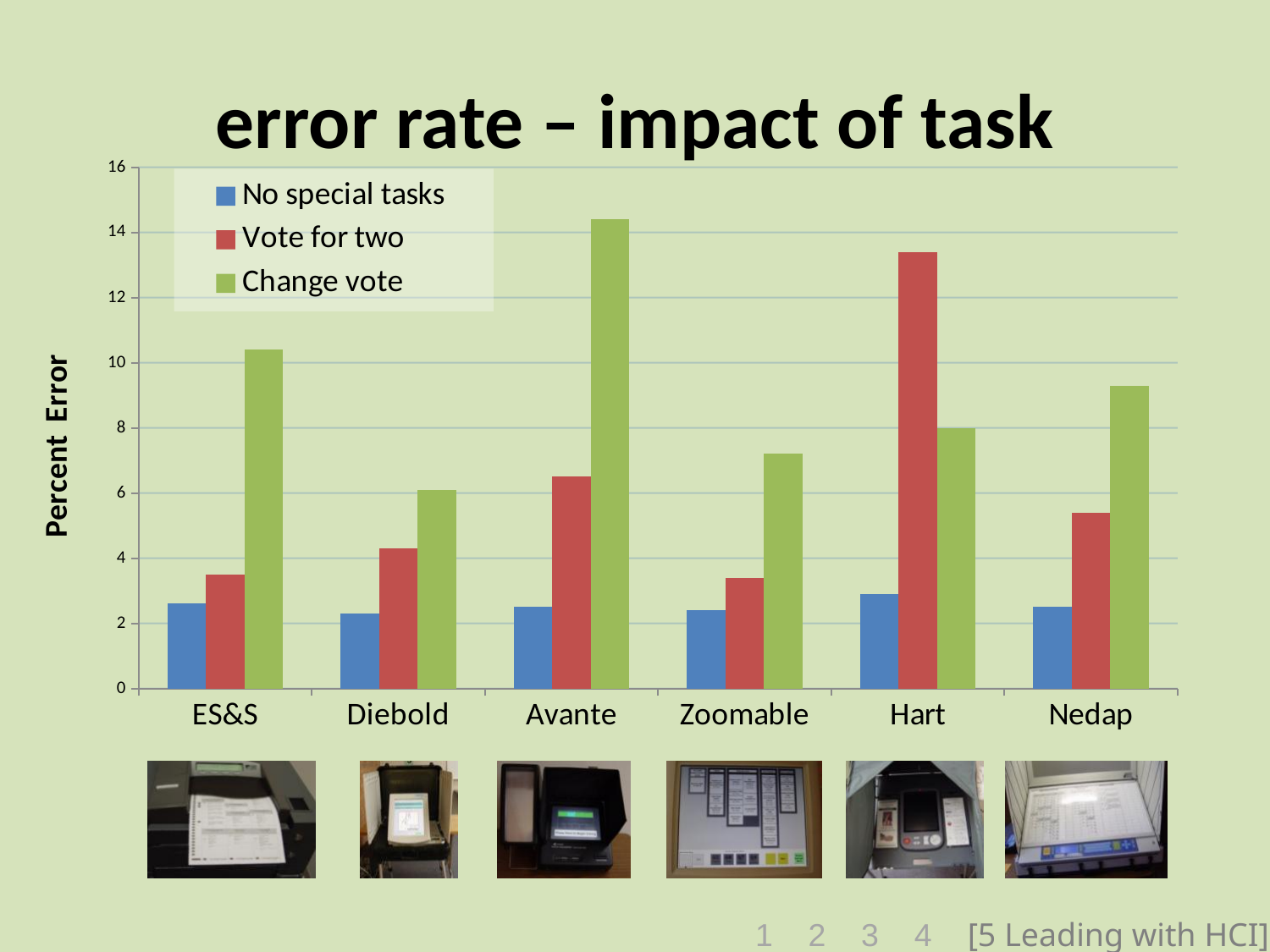
For Hart, which task has the higher error rate: Vote for two or Change vote? Vote for two How many voting systems (categories) are shown on the x axis? 6 Is the Vote for two error rate for Diebold greater or less than 6? less Is the Change vote error rate for ES&S greater or less than 8? greater What is the label of the y axis? Percent Error How many series does the legend list? 3 Is the Change vote error rate for Avante greater or less than 12? greater Which voting system has the highest error rate for the Vote for two task? Hart What kind of chart is shown on the slide? bar chart Which voting system has the highest error rate for the Change vote task? Avante Which voting system has the lowest error rate for the Change vote task? Diebold